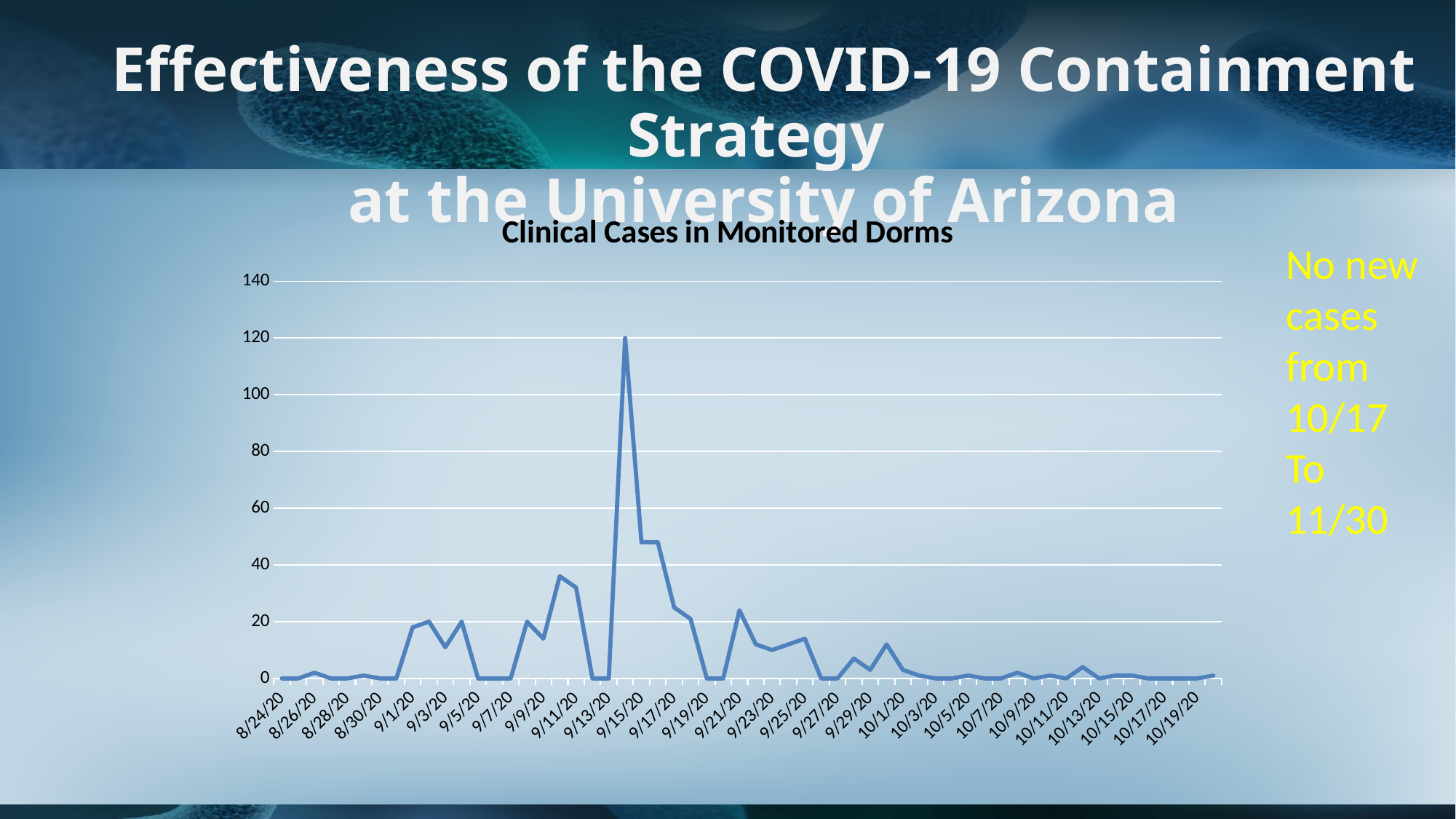
Is the value for 9/11/20 greater or less than 20? greater What is the highest value shown on the y axis of the chart? 140 How many date labels are shown along the x axis of the chart? 29 What is the title of the chart? Clinical Cases in Monitored Dorms Which date has the larger value, 9/1/20 or 9/15/20? 9/15/20 What is the value for 9/19/20? 0 Is the value for 9/15/20 greater or less than 40? greater Do the values generally rise or fall from 9/15/20 to 10/19/20? fall What is the value for 8/24/20? 0 What type of chart is shown on the slide? line chart Is the peak value of the line greater or less than 100? greater What is the value for 9/5/20? 0